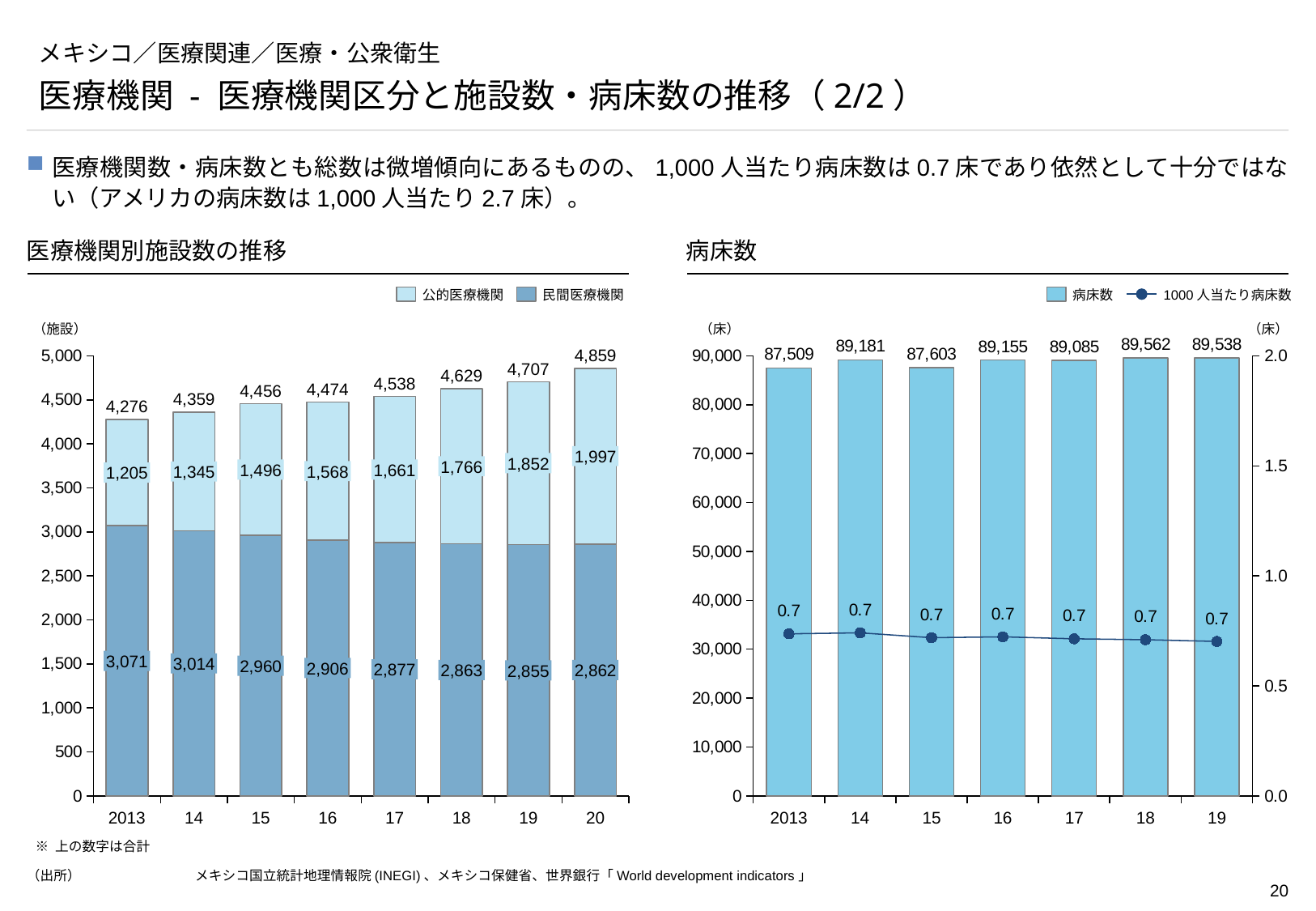
In the 病床数 chart, what is the value for 病床数 in 2013? 87,509 In the 病床数 chart, which year has the highest value for 病床数? 18 In the 医療機関別施設数の推移 chart, what is the value for 公的医療機関 in 20? 1,997 In the 医療機関別施設数の推移 chart, does the value for 公的医療機関 rise or fall from 2013 to 20? rise In the 医療機関別施設数の推移 chart, what is the total of the stacked bar for 18? 4,629 In the 医療機関別施設数の推移 chart, what is the value for 民間医療機関 in 2013? 3,071 In the 医療機関別施設数の推移 chart, which year has the highest total number of facilities? 20 In the 医療機関別施設数の推移 chart, what is the difference between the 民間医療機関 values for 2013 and 20? 209 How many years are shown on the x axis of the 病床数 chart? 7 How many series does the legend of the 医療機関別施設数の推移 chart list? 2 In the 病床数 chart, which is larger, the 病床数 value for 14 or for 15? 14 In the 医療機関別施設数の推移 chart, which year has the lowest value for 公的医療機関? 2013